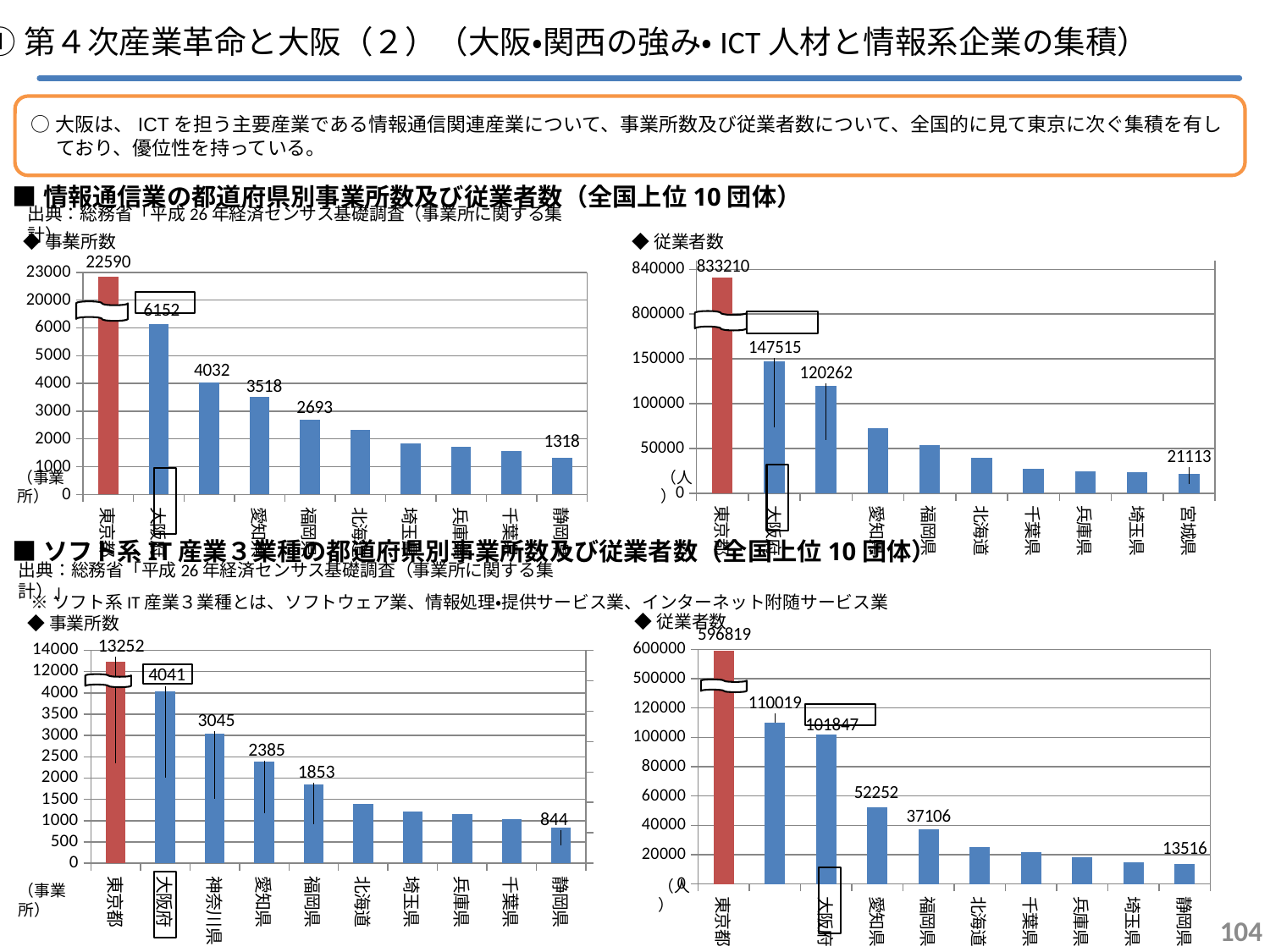
In the bottom-left chart (ソフト系IT産業 事業所数), which is larger, 愛知県 or 福岡県? 愛知県 In the top-left chart (情報通信業 事業所数), what is the difference between 大阪府 and 愛知県? 2634 In the bottom-right chart (ソフト系IT産業 従業者数), what is the value for 大阪府? 101847 In the top-left chart (情報通信業 事業所数), what is the value for 東京都? 22590 In the top-right chart (情報通信業 従業者数), which prefecture has the lowest value? 宮城県 In the top-left chart (情報通信業 事業所数), what is the value for 大阪府? 6152 In the bottom-left chart (ソフト系IT産業 事業所数), what is the value for 神奈川県? 3045 In the bottom-left chart (ソフト系IT産業 事業所数), how many prefectures are shown? 10 In the bottom-right chart (ソフト系IT産業 従業者数), what is the difference between 東京都 and 大阪府? 494972 In the top-right chart (情報通信業 従業者数), what is the value for 東京都? 833210 What kind of chart is the bottom-right chart (ソフト系IT産業 従業者数)? bar chart